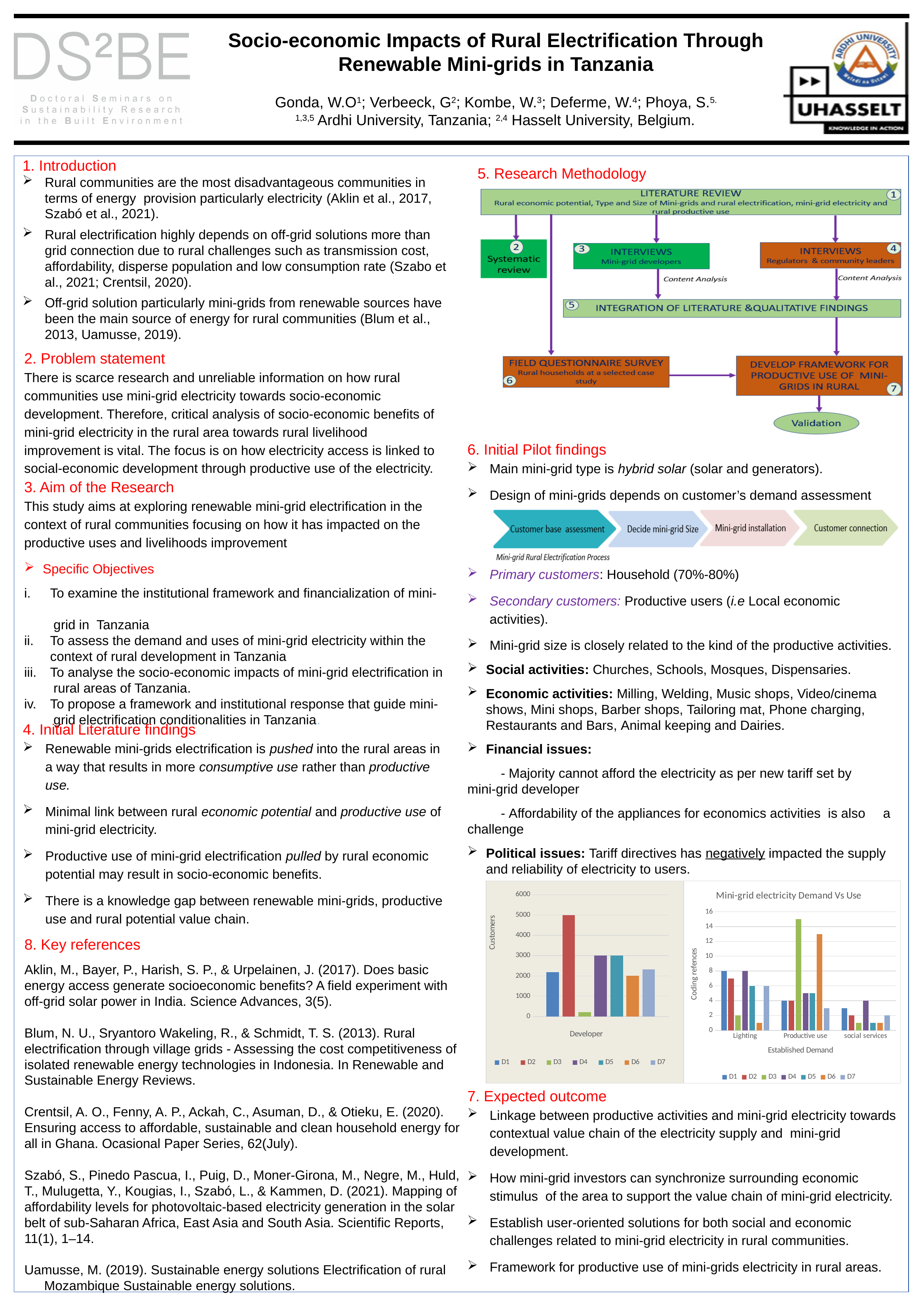
In the chart 'Mini-grid electricity Demand Vs Use', how many categories are shown on the x axis? 3 In the left chart (Customers by Developer), which developer has the highest number of customers? D2 What is the label on the vertical axis of the left chart? Customers In the left chart (Customers by Developer), how many series does the legend list? 7 What kind of chart is the left chart showing customers by developer? bar chart In the chart 'Mini-grid electricity Demand Vs Use', is the value for D3 under Productive use greater or less than 12? greater What is the title of the right chart? Mini-grid electricity Demand Vs Use In the left chart (Customers by Developer), is the value for D2 greater or less than 4000? greater In the chart 'Mini-grid electricity Demand Vs Use', which series has the highest value for Productive use? D3 In the left chart (Customers by Developer), is the value for D3 greater or less than 1000? less In the left chart (Customers by Developer), which developer has the lowest number of customers? D3 In the chart 'Mini-grid electricity Demand Vs Use', which is larger for Productive use: D6 or D1? D6